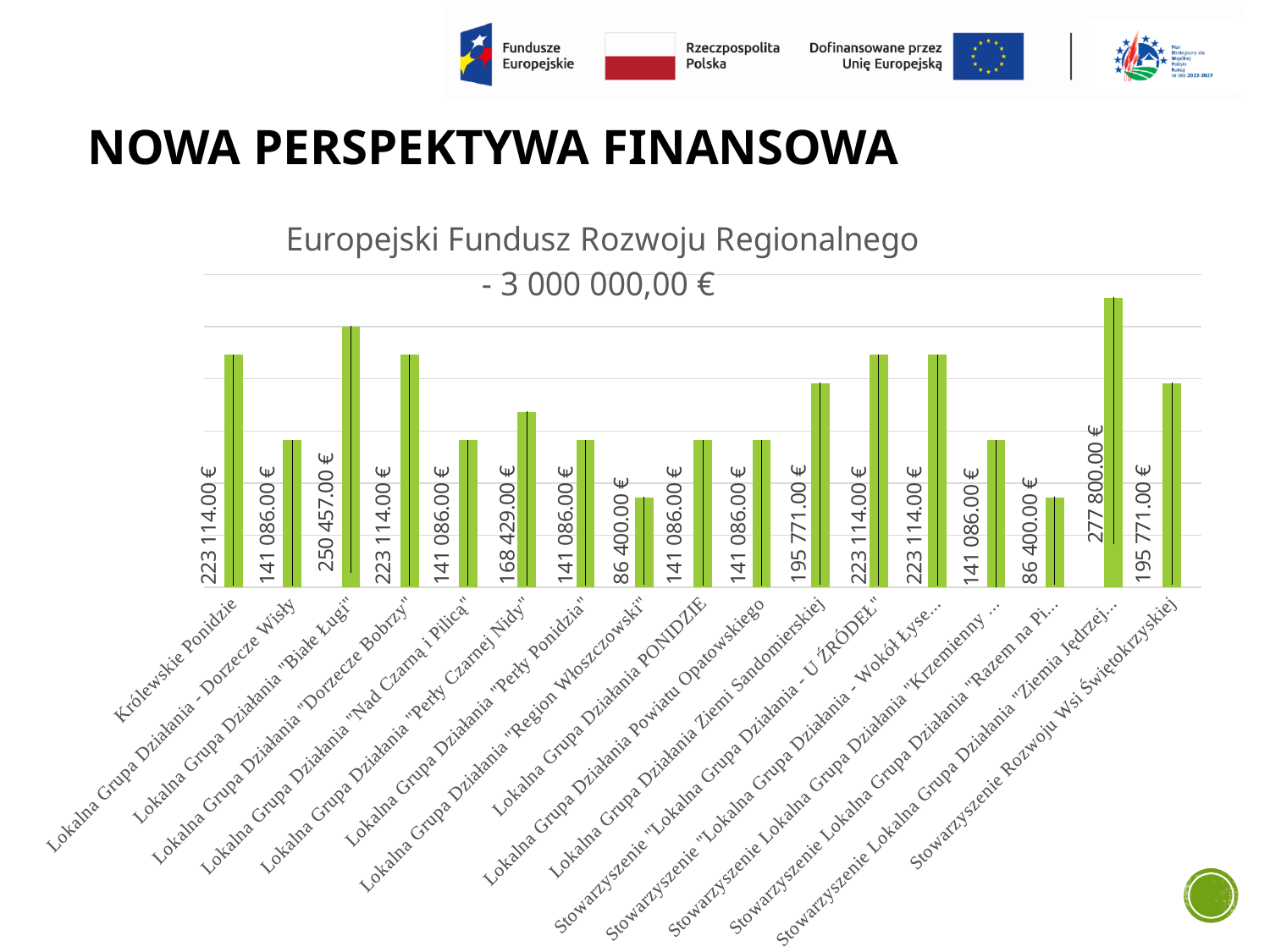
How many categories are shown in the chart? 17 What is the value for Stowarzyszenie Rozwoju Wsi Świętokrzyskiej? 195 771.00 € What is the value for Lokalna Grupa Działania "Perły Czarnej Nidy"? 168 429.00 € What is the lowest value shown in the chart? 86 400.00 € What is the value for Lokalna Grupa Działania "Region Włoszczowski"? 86 400.00 € What is the value for Lokalna Grupa Działania "Białe Ługi"? 250 457.00 € What kind of chart is shown on the slide? Bar chart What is the difference between the value for Stowarzyszenie Lokalna Grupa Działania "Ziemia Jędrzej..." and the value for Lokalna Grupa Działania "Białe Ługi"? 27 343.00 € What is the difference between the value for Królewskie Ponidzie and the value for Lokalna Grupa Działania - Dorzecze Wisły? 82 028.00 € Which is larger: the value for Lokalna Grupa Działania Ziemi Sandomierskiej or the value for Lokalna Grupa Działania "Perły Czarnej Nidy"? Lokalna Grupa Działania Ziemi Sandomierskiej What is the value for Królewskie Ponidzie? 223 114.00 € Which category has the highest value? Stowarzyszenie Lokalna Grupa Działania "Ziemia Jędrzej..."